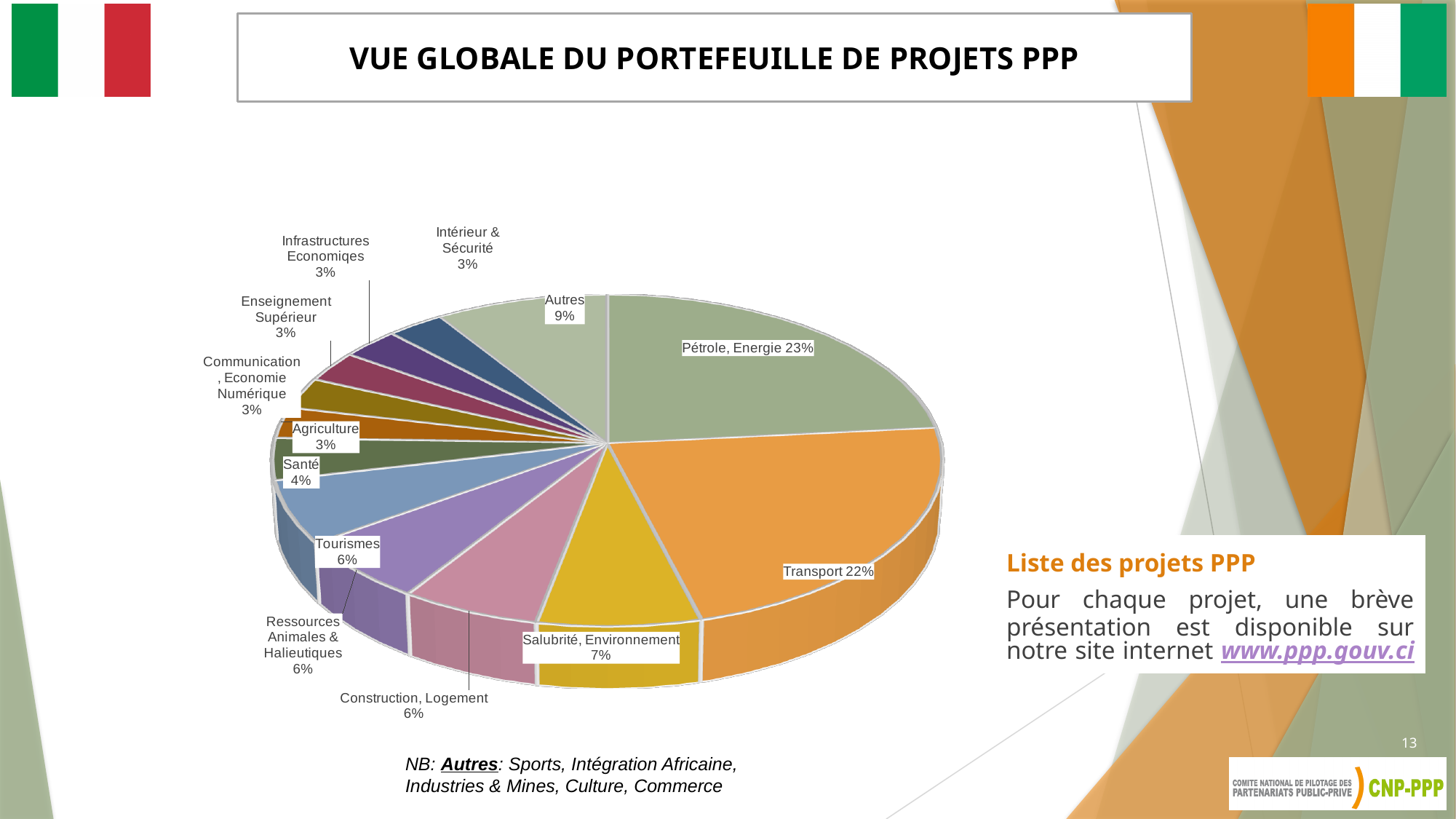
What percentage is shown for Salubrité, Environnement? 7% Which category has the largest share of the pie? Pétrole, Energie What share is labelled for Autres? 9% What percentage is shown for Santé? 4% What is the difference in percentage points between Pétrole, Energie and Transport? 1% Which is larger, the share for Tourismes or the share for Santé? Tourismes What share of the pie does Transport represent? 22% What kind of chart is shown on the slide? pie chart What share of the PPP project portfolio is Pétrole, Energie? 23% How many slices does the pie chart have? 13 What is the title of the slide containing the pie chart? VUE GLOBALE DU PORTEFEUILLE DE PROJETS PPP What is the smallest percentage shown for any slice of the pie? 3%